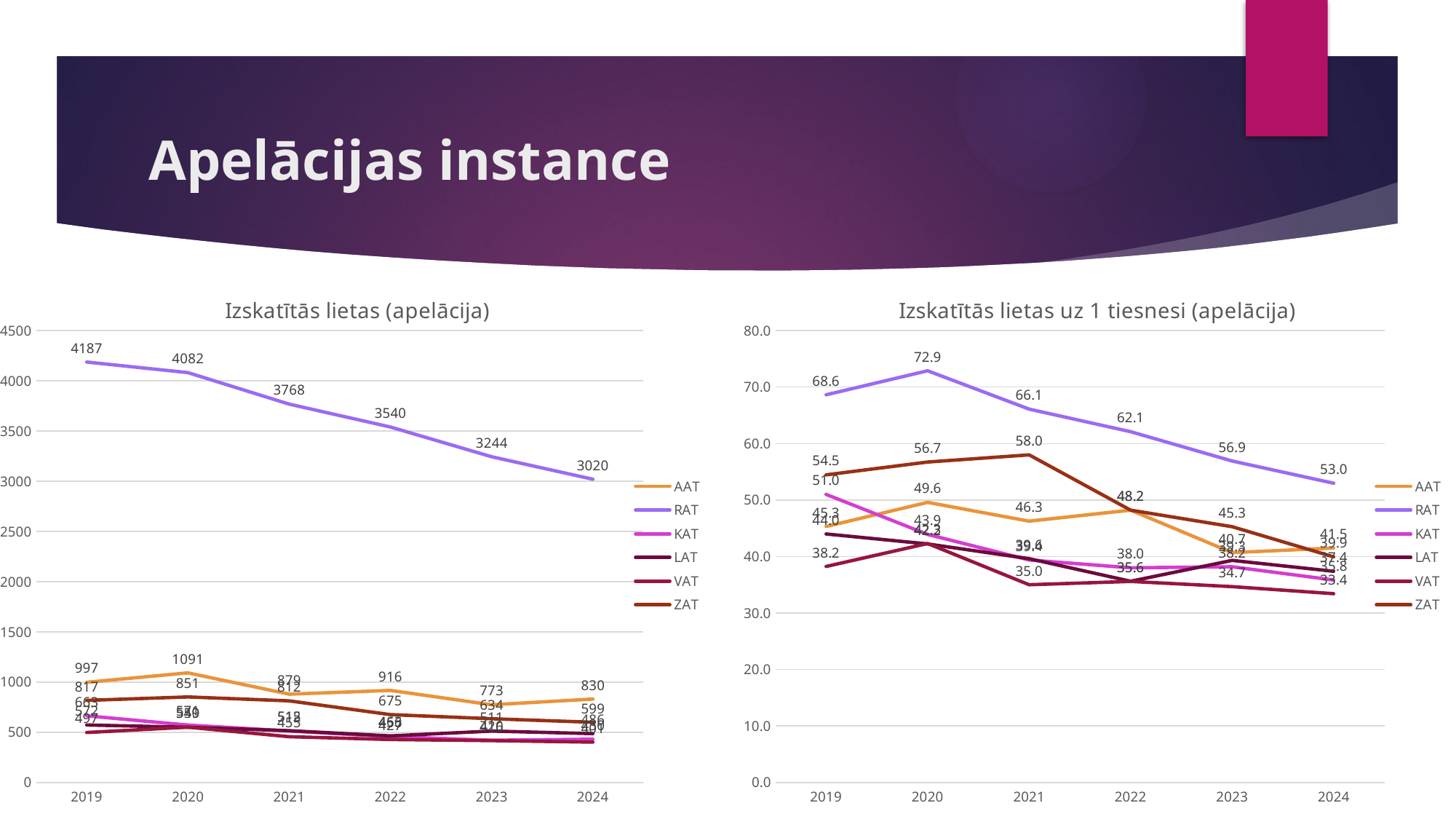
In the left chart "Izskatītās lietas (apelācija)", what is the difference between the RAT values for 2019 and 2024? 1167 In the right chart "Izskatītās lietas uz 1 tiesnesi (apelācija)", in which year is the RAT value highest? 2020 In the right chart "Izskatītās lietas uz 1 tiesnesi (apelācija)", what is the value for ZAT in 2021? 58.0 In the right chart "Izskatītās lietas uz 1 tiesnesi (apelācija)", what is the value for RAT in 2020? 72.9 How many series does the legend of the left chart "Izskatītās lietas (apelācija)" list? 6 In the right chart "Izskatītās lietas uz 1 tiesnesi (apelācija)", which series has the larger value in 2019, RAT or AAT? RAT In the left chart "Izskatītās lietas (apelācija)", does the RAT series rise or fall from 2019 to 2024? fall In the left chart "Izskatītās lietas (apelācija)", what is the value for AAT in 2020? 1091 In the left chart "Izskatītās lietas (apelācija)", what is the value for RAT in 2024? 3020 What kind of chart is the left chart titled "Izskatītās lietas (apelācija)"? line chart In the left chart "Izskatītās lietas (apelācija)", what is the value for RAT in 2019? 4187 In the left chart "Izskatītās lietas (apelācija)", what is the value for ZAT in 2019? 817